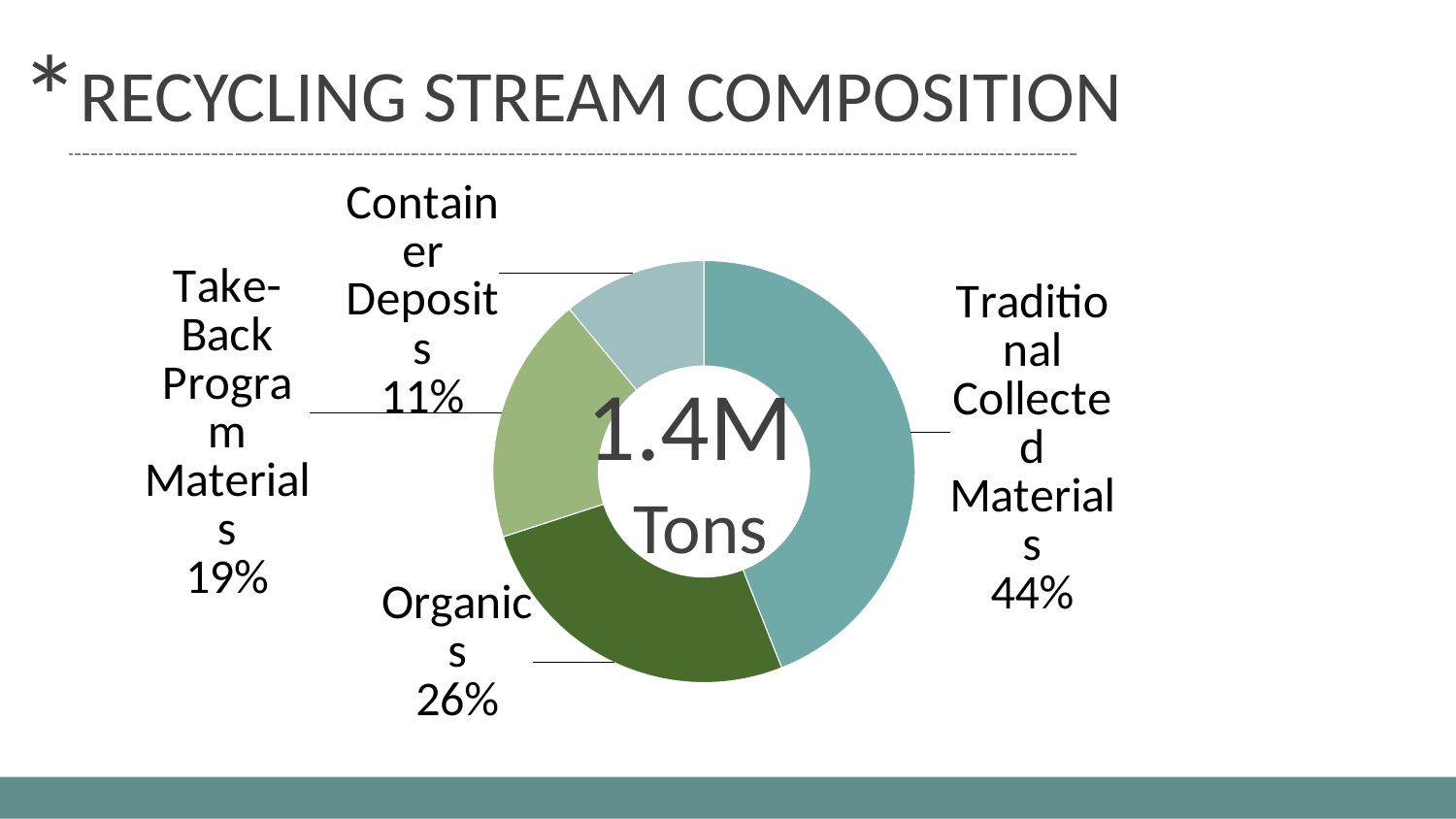
Which category has the smallest share of the recycling stream? Container Deposits Which is larger, the share for Organics or the share for Take-Back Program Materials? Organics What share of the recycling stream is Organics? 26% What is the title of the slide? RECYCLING STREAM COMPOSITION What is the difference in percentage points between Traditional Collected Materials and Organics? 18 percentage points What total is shown in the centre of the chart? 1.4M Tons What share of the recycling stream is Traditional Collected Materials? 44% What kind of chart is shown on the slide? Doughnut (pie) chart What share of the recycling stream is Container Deposits? 11% How many categories are shown in the chart? 4 Which category has the largest share of the recycling stream? Traditional Collected Materials